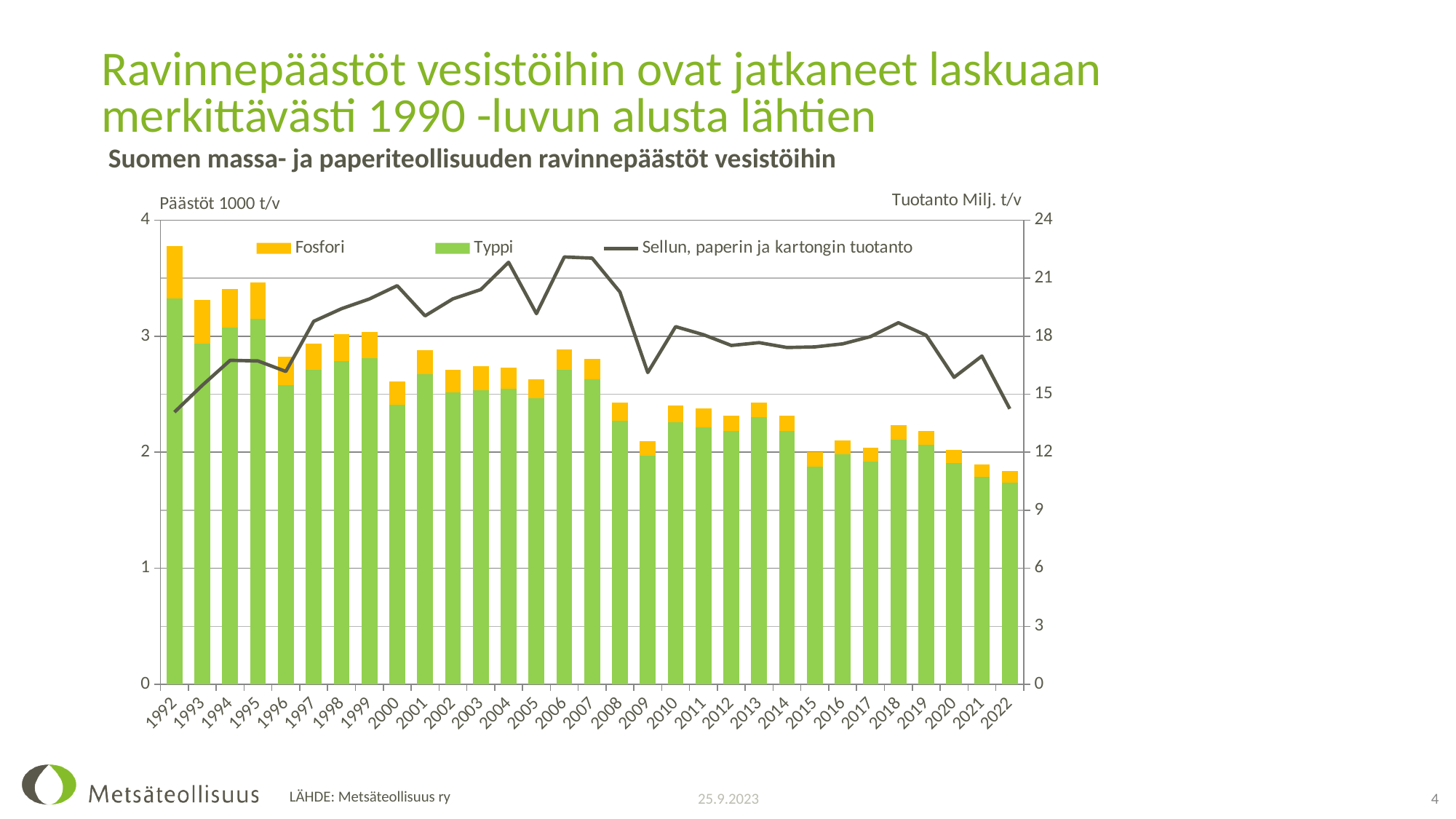
Is the total emissions value for 2022 greater or less than 2? less Is the production (Sellun, paperin ja kartongin tuotanto) value for 2006 greater or less than 21? greater What kind of chart is shown on the slide? A stacked bar chart combined with a line chart Which year has the highest total nutrient emissions (tallest stacked bar)? 1992 Which year has the larger total emissions, 1995 or 1996? 1995 Is the total emissions value for 1992 greater or less than 3? greater What is the label of the left vertical axis? Päästöt 1000 t/v How many series does the legend list? 3 How many years are shown on the x axis? 31 Which year has the lowest total nutrient emissions (shortest stacked bar)? 2022 Do the total nutrient emissions generally rise or fall from 1992 to 2022? fall